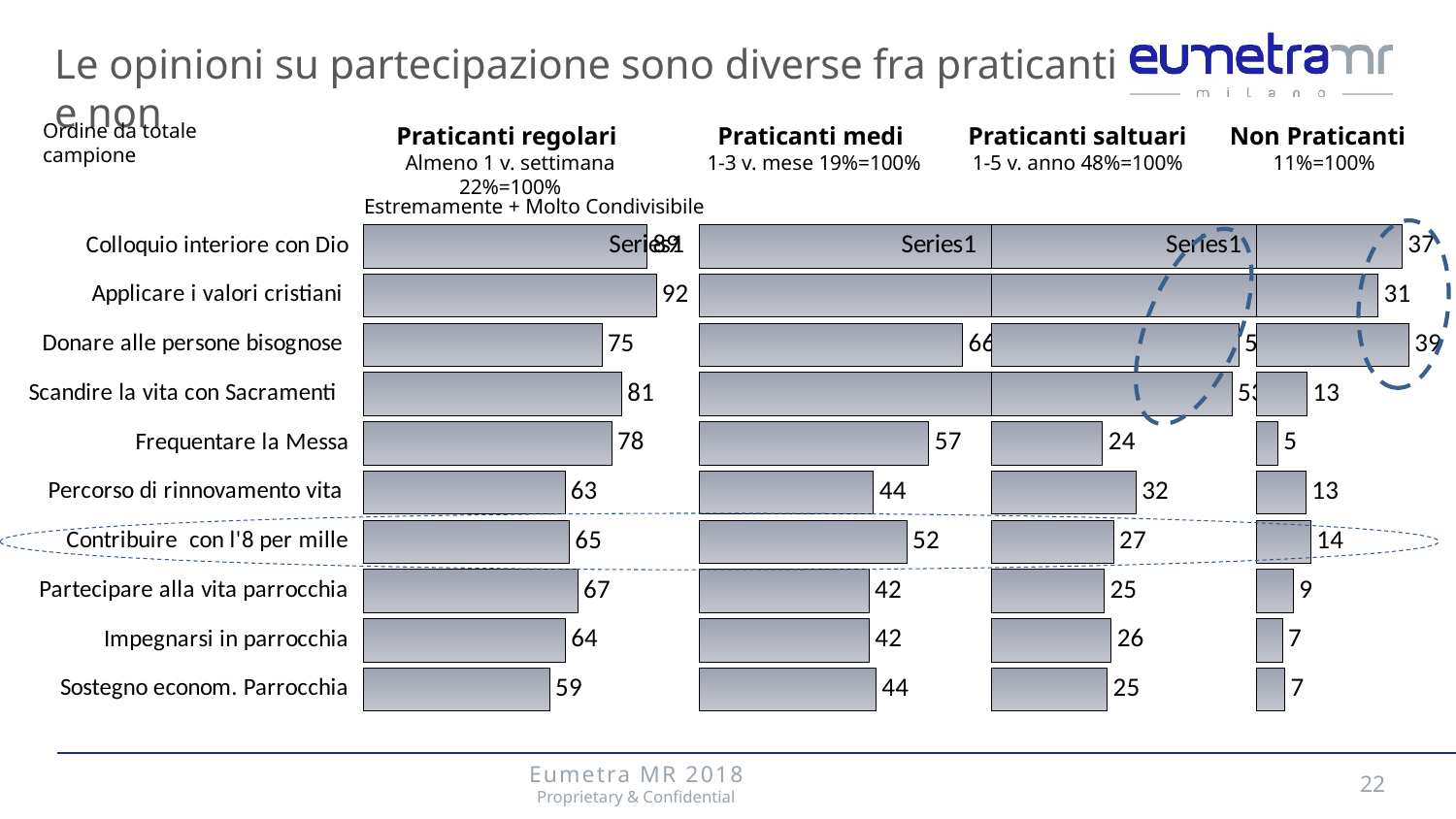
In the Praticanti regolari chart, what is the difference between Applicare i valori cristiani and Sostegno econom. Parrocchia? 33 In the Non Praticanti chart, what is the difference between Donare alle persone bisognose and Frequentare la Messa? 34 In the Praticanti regolari chart, what is the value for Applicare i valori cristiani? 92 In the Non Praticanti chart, which category has the lowest value? Frequentare la Messa In the Non Praticanti chart, what is the value for Donare alle persone bisognose? 39 In the Praticanti medi chart, what is the value for Frequentare la Messa? 57 In the Praticanti regolari chart, which category has the lowest value? Sostegno econom. Parrocchia In the Praticanti medi chart, which is larger: Frequentare la Messa or Contribuire con l'8 per mille? Frequentare la Messa What kind of chart is used for the Non Praticanti data? Bar chart In the Non Praticanti chart, which category has the highest value? Donare alle persone bisognose How many categories are shown in the Praticanti saltuari chart? 10 In the Praticanti saltuari chart, what is the value for Percorso di rinnovamento vita? 32